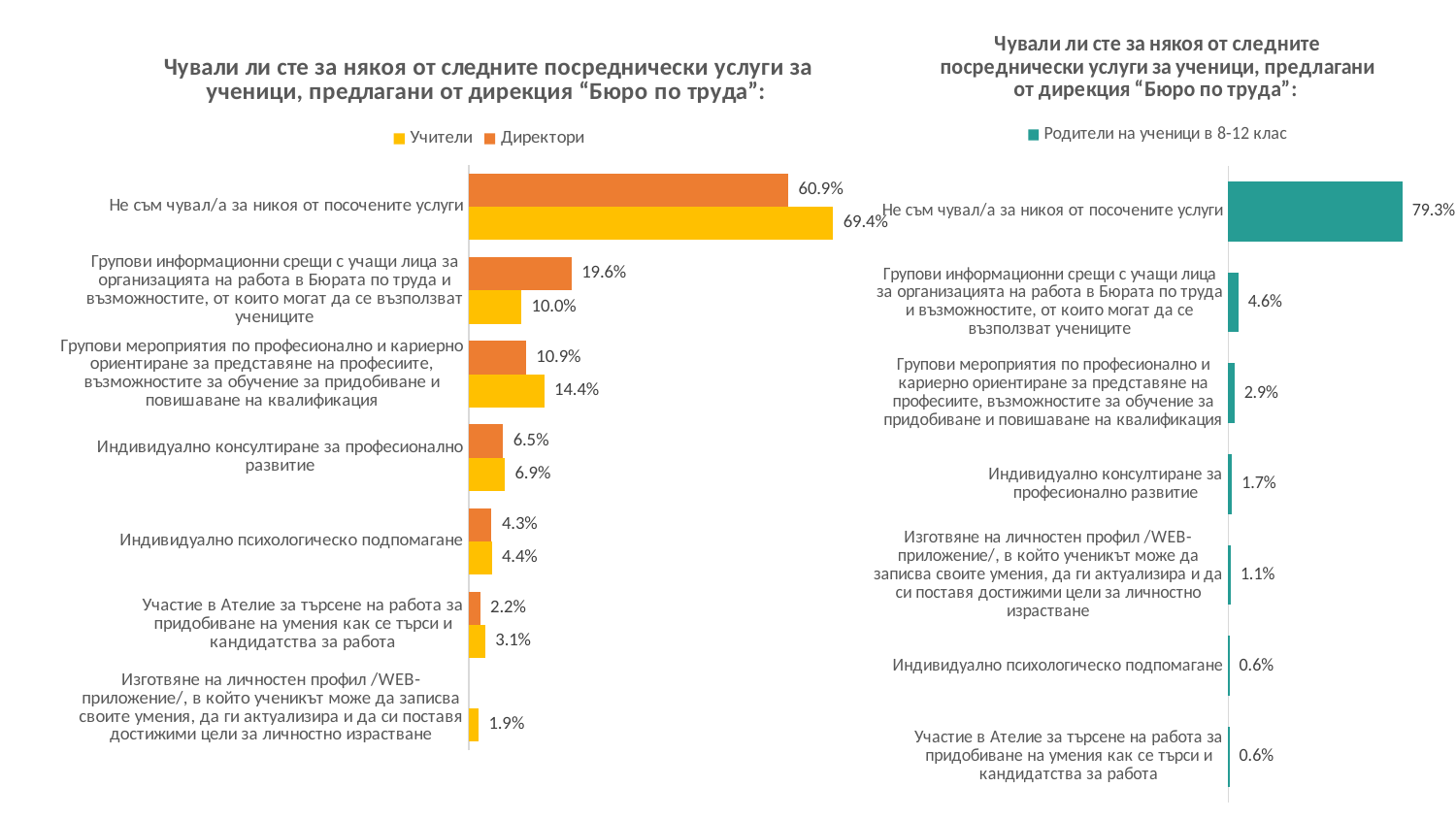
On the left chart, for 'Групови информационни срещи с учащи лица', which series has the larger value, Учители or Директори? Директори On the left chart, which category has the highest value for Учители? Не съм чувал/а за никоя от посочените услуги How many categories are shown on the right chart? 7 On the left chart, what is the value for Учители for 'Групови мероприятия по професионално и кариерно ориентиране'? 14.4% On the left chart, what is the difference between Учители and Директори for 'Не съм чувал/а за никоя от посочените услуги'? 8.5% On the right chart, what is the value for 'Индивидуално консултиране за професионално развитие'? 1.7% On the right chart, what is the value for 'Не съм чувал/а за никоя от посочените услуги'? 79.3% On the left chart, what is the value for Директори for 'Не съм чувал/а за никоя от посочените услуги'? 60.9% What type of chart is the right chart? Bar chart On the right chart, which category has the highest value? Не съм чувал/а за никоя от посочените услуги How many series does the legend of the left chart list? 2 On the right chart, what is the difference between 'Групови информационни срещи' and 'Групови мероприятия по професионално и кариерно ориентиране'? 1.7%